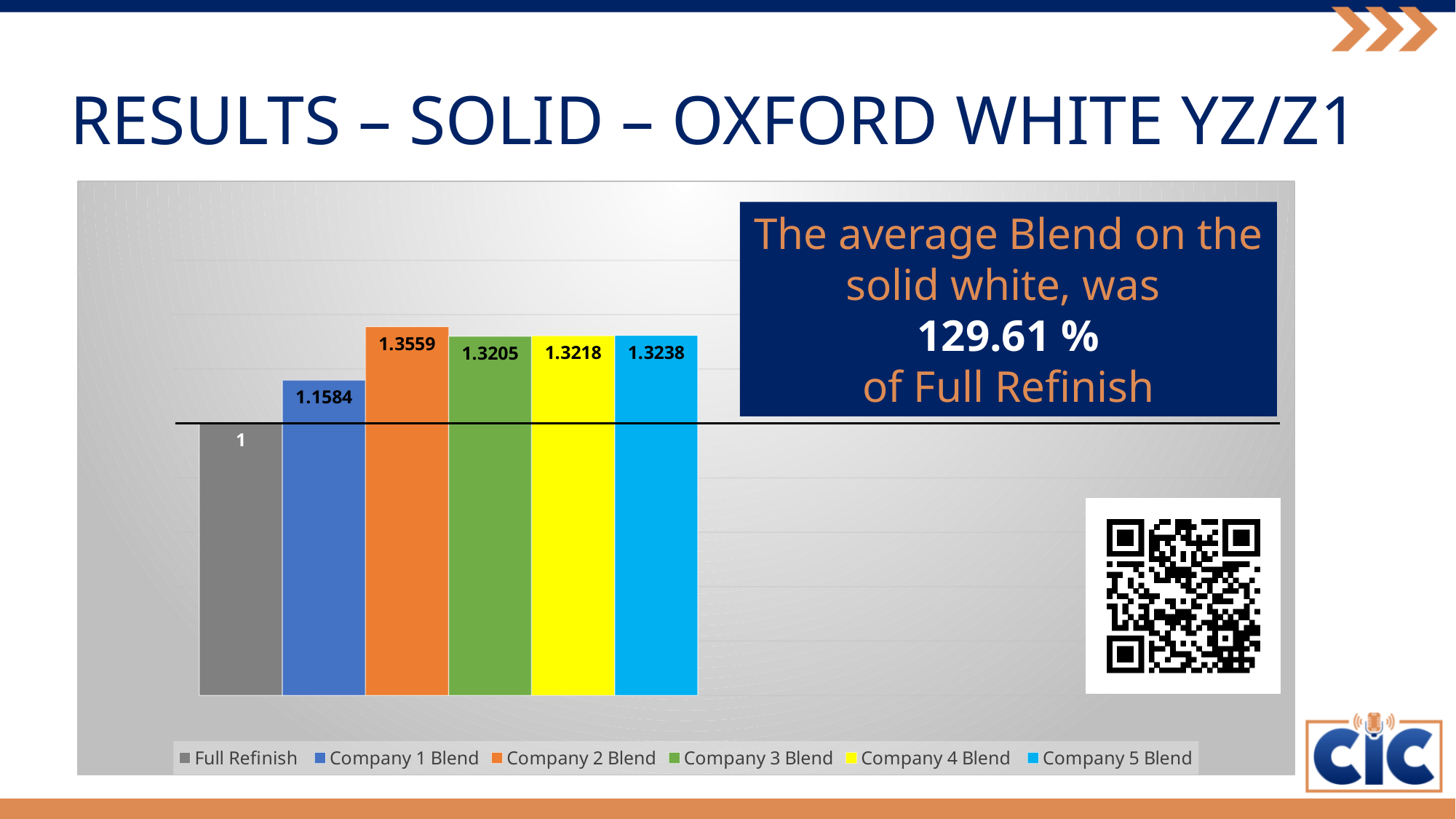
What is the difference between the Company 2 Blend value and the Full Refinish value? 0.3559 Which series has the highest value? Company 2 Blend What is the value for Company 5 Blend? 1.3238 How many series does the legend list? 6 Which series has the lowest value? Full Refinish What colour is the bar for Company 4 Blend? Yellow What is the value for Company 2 Blend? 1.3559 What is the value for Company 1 Blend? 1.1584 What kind of chart is shown on the slide? Bar chart What is the difference between the Company 5 Blend value and the Company 1 Blend value? 0.1654 What is the value for Full Refinish? 1 Which is larger, the value for Company 1 Blend or the value for Company 3 Blend? Company 3 Blend